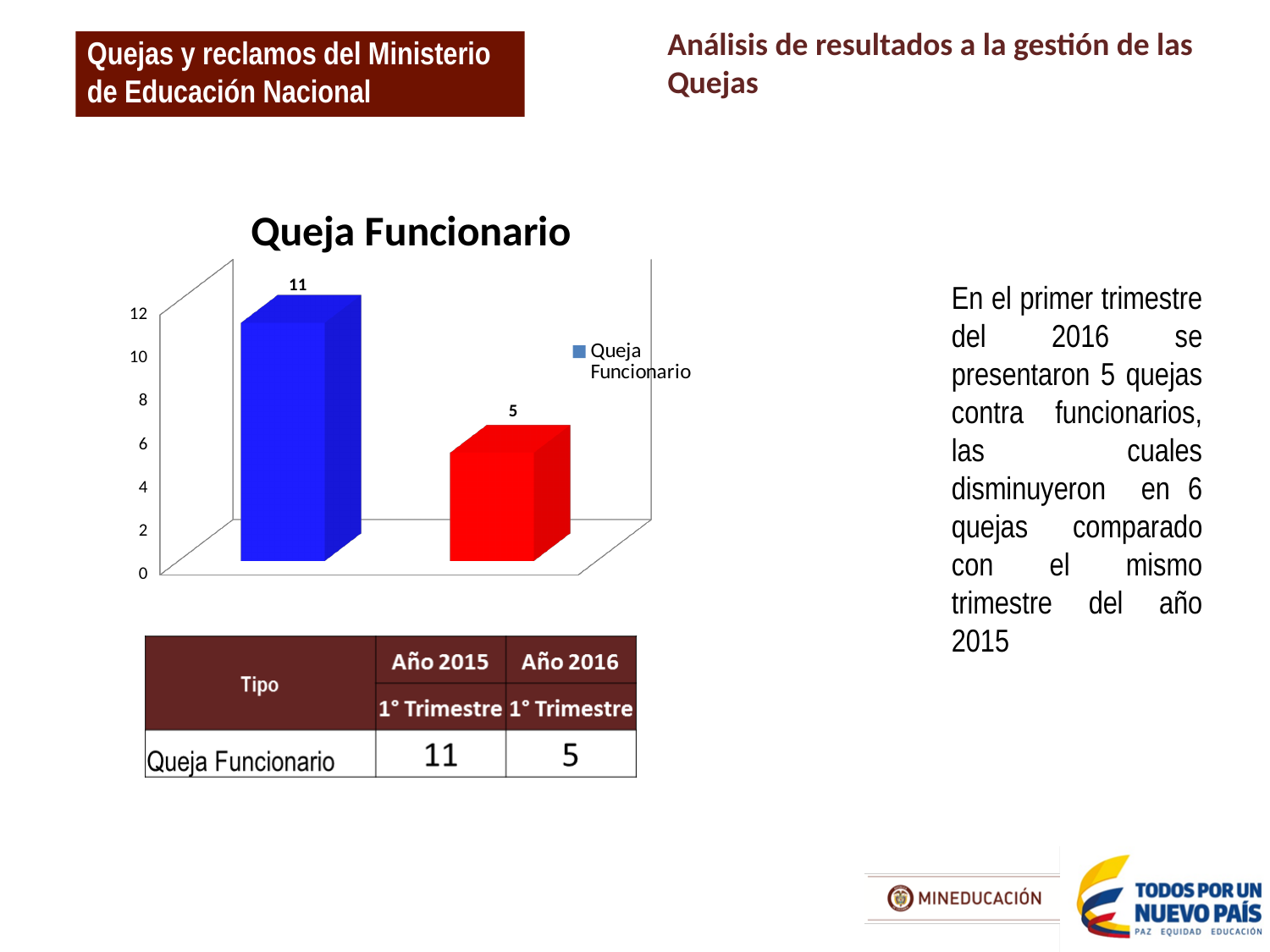
Is the value of the blue bar in the Queja Funcionario chart greater or less than 10? greater What is the title of the chart on the slide? Queja Funcionario What kind of chart is the Queja Funcionario chart? bar chart How many series does the legend of the Queja Funcionario chart list? 1 What is the value shown on the red (right) bar in the Queja Funcionario chart? 5 In the Queja Funcionario chart, is the left bar larger or smaller than the right bar? larger Is the value of the red bar in the Queja Funcionario chart greater or less than 8? less Which bar in the Queja Funcionario chart is the highest, the blue one or the red one? the blue one How many bars are plotted in the Queja Funcionario chart? 2 What is the value shown on the blue (left) bar in the Queja Funcionario chart? 11 What is the difference between the two bar values in the Queja Funcionario chart? 6 Which bar in the Queja Funcionario chart is the lowest, the blue one or the red one? the red one